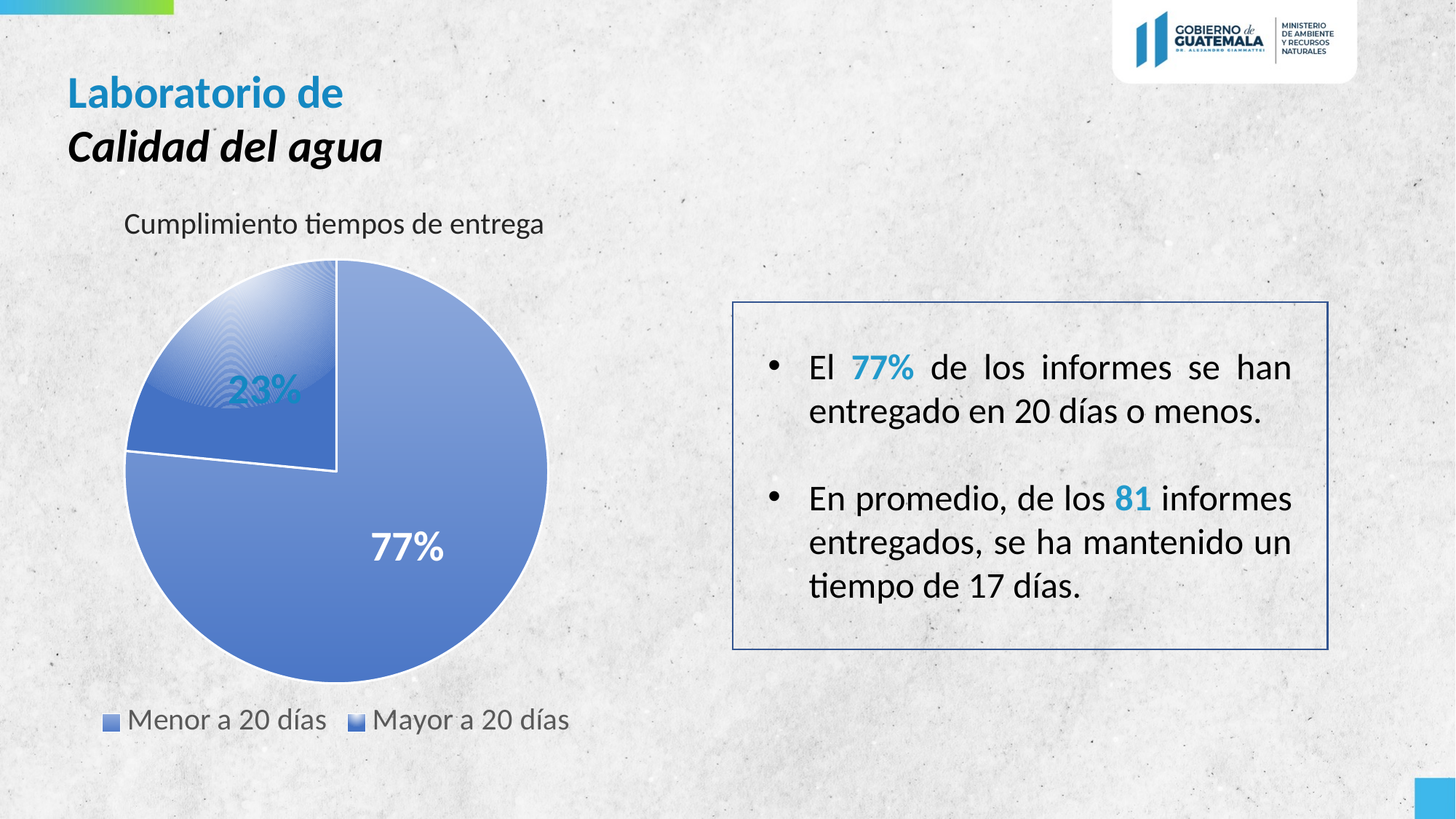
How many entries does the legend list? 2 What kind of chart is shown on the slide? pie chart Which slice is the smallest in the pie chart? Mayor a 20 días What is the difference in percentage points between 'Menor a 20 días' and 'Mayor a 20 días'? 54 What share of the pie is 'Mayor a 20 días'? 23% What is the title of the chart? Cumplimiento tiempos de entrega How many slices does the pie chart have? 2 Which is larger, 'Menor a 20 días' or 'Mayor a 20 días'? Menor a 20 días Which slice is the largest in the pie chart? Menor a 20 días What are the two legend entries of the chart? Menor a 20 días, Mayor a 20 días What share of the pie is 'Menor a 20 días'? 77%